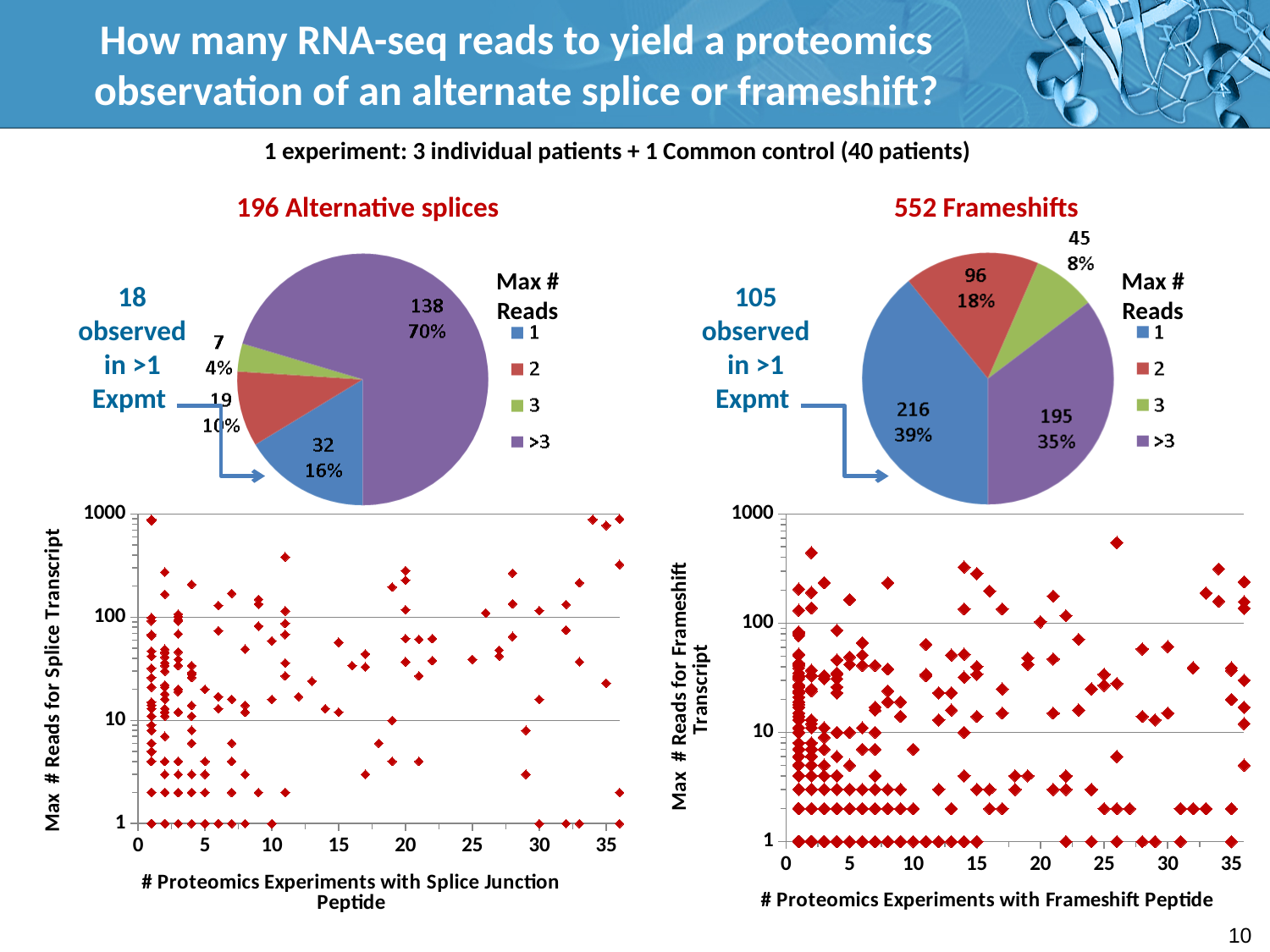
In the '196 Alternative splices' pie chart, which max # reads category has the smallest slice? 3 In the '552 Frameshifts' pie chart, which max # reads category has the largest slice? 1 In the '196 Alternative splices' pie chart, what percentage share does the '1' max # reads slice have? 16% In the '552 Frameshifts' pie chart, what is the difference between the count for '1' and the count for '>3'? 21 What is the x-axis title of the bottom-right chart? # Proteomics Experiments with Frameshift Peptide In the '552 Frameshifts' pie chart, what percentage share does the '3' slice have? 8% What kind of chart is the bottom-left chart with the y axis 'Max # Reads for Splice Transcript'? Scatter plot In the '196 Alternative splices' pie chart, how many alternative splices have a max # reads of >3? 138 How many categories does the legend of the '196 Alternative splices' pie chart list? 4 In the '552 Frameshifts' pie chart, which is larger: the count for '1' or the count for '>3'? 1 In the '196 Alternative splices' pie chart, what is the difference between the count for '>3' and the count for '1'? 106 In the '552 Frameshifts' pie chart, how many frameshifts have a max # reads of 2? 96